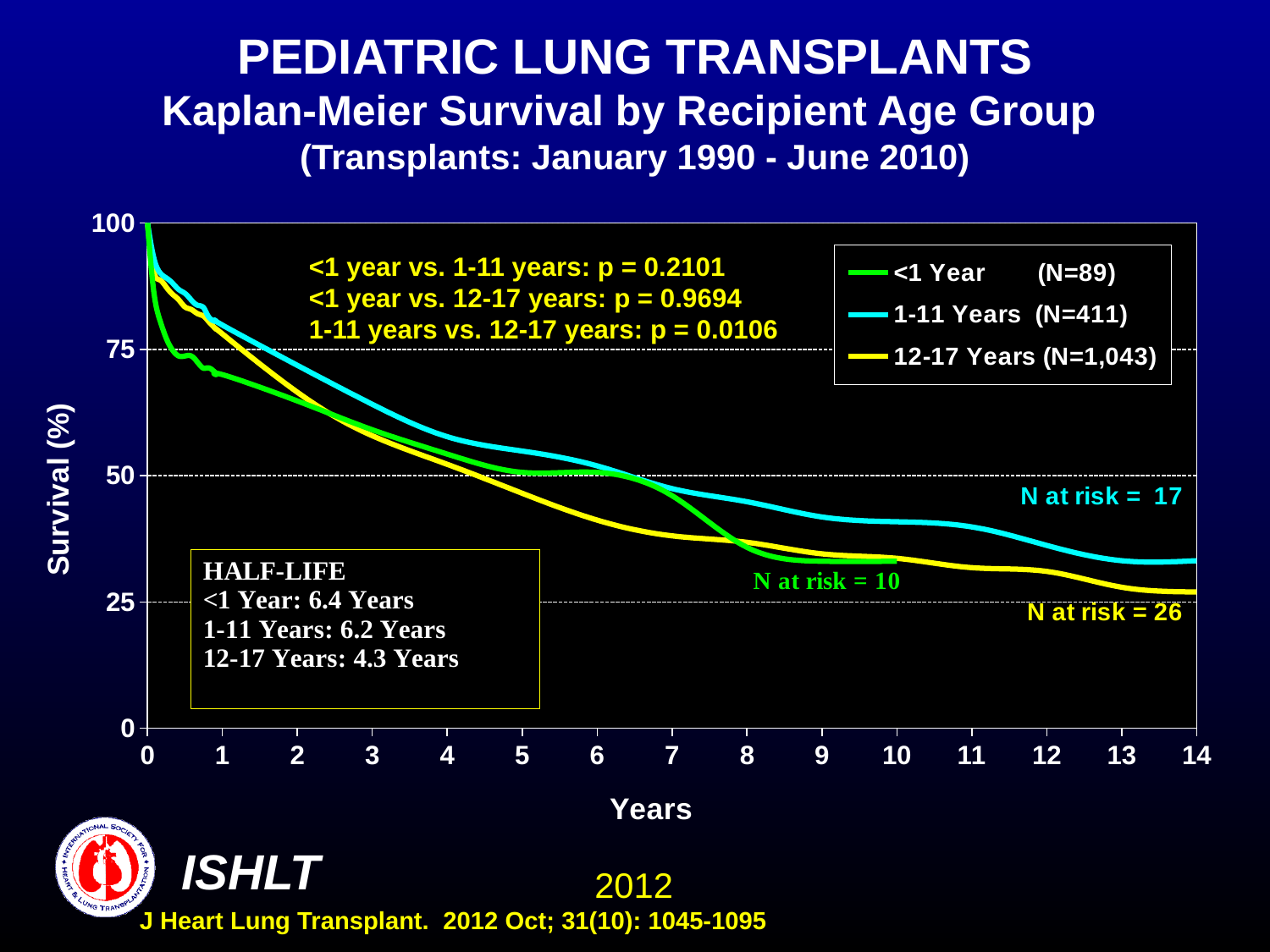
Is the survival value for the 1-11 Years group at 10 years greater or less than 50? less What is the p-value for 1-11 years vs. 12-17 years? 0.0106 Is the survival value for the <1 Year group at 1 year greater or less than 75? less Do the survival curves rise or fall as years increase? fall How many series does the legend list? 3 What kind of chart is shown on the slide? line chart What is the N at risk shown for the 1-11 Years group? 17 At 8 years, which group has higher survival: <1 Year or 1-11 Years? 1-11 Years Which age group has the shortest half-life? 12-17 Years What is the N for the 12-17 Years group shown in the legend? 1,043 What is the difference in half-life between the <1 Year group and the 12-17 Years group? 2.1 Years What is the half-life for the <1 Year group? 6.4 Years